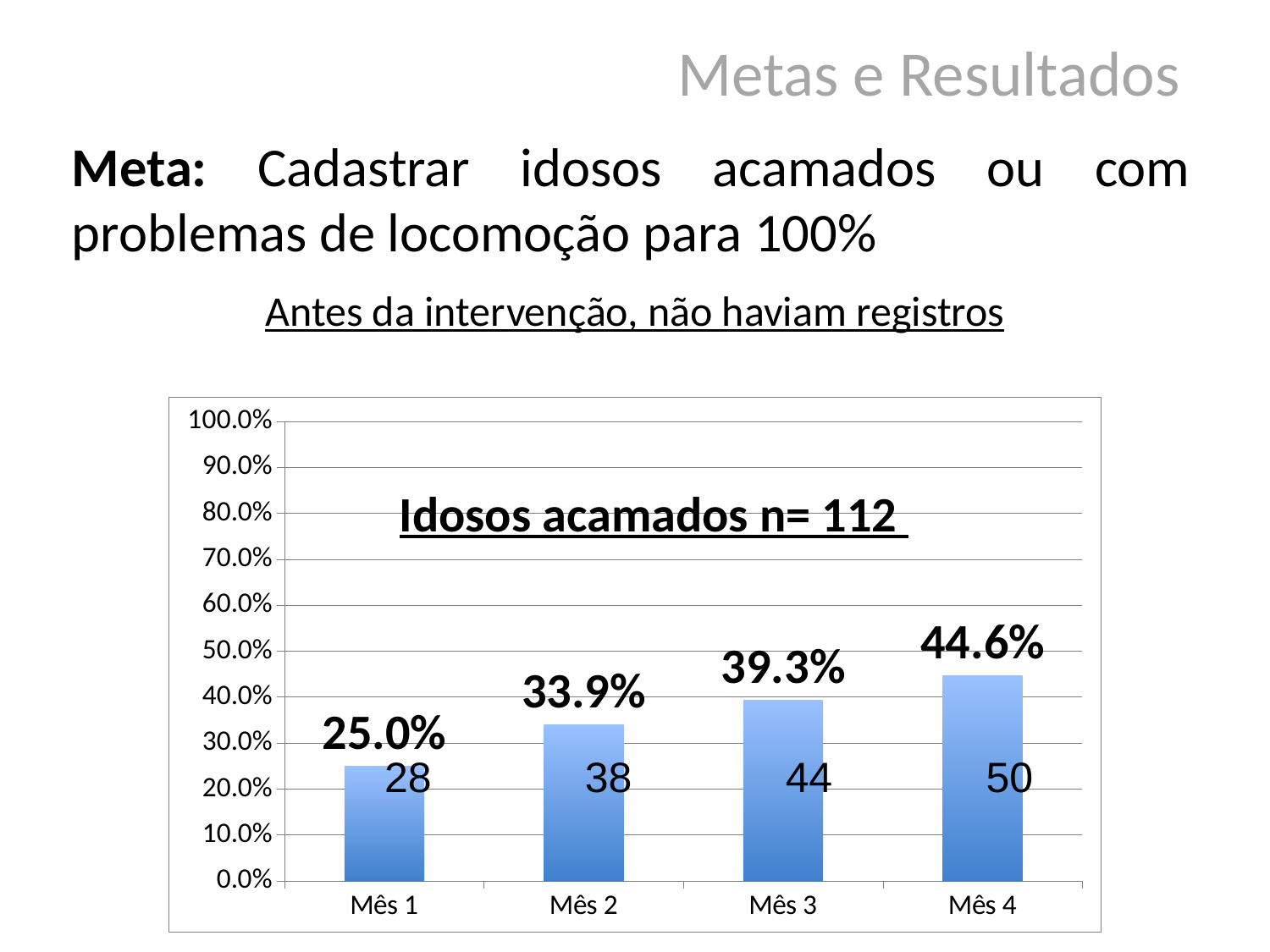
What kind of chart is shown on the slide? bar chart What is the percentage value for Mês 1? 25.0% Which month has the lowest percentage? Mês 1 What is the percentage value for Mês 4? 44.6% Do the values rise or fall from Mês 1 to Mês 4? rise Is the value for Mês 4 greater or less than 50.0%? less Which month has the highest percentage? Mês 4 How many months (categories) are shown on the x axis? 4 Which is larger, the value for Mês 2 or the value for Mês 3? Mês 3 What is the difference in percentage points between Mês 4 and Mês 1? 19.6 What is the percentage value for Mês 3? 39.3% What count is shown inside the bar for Mês 2? 38